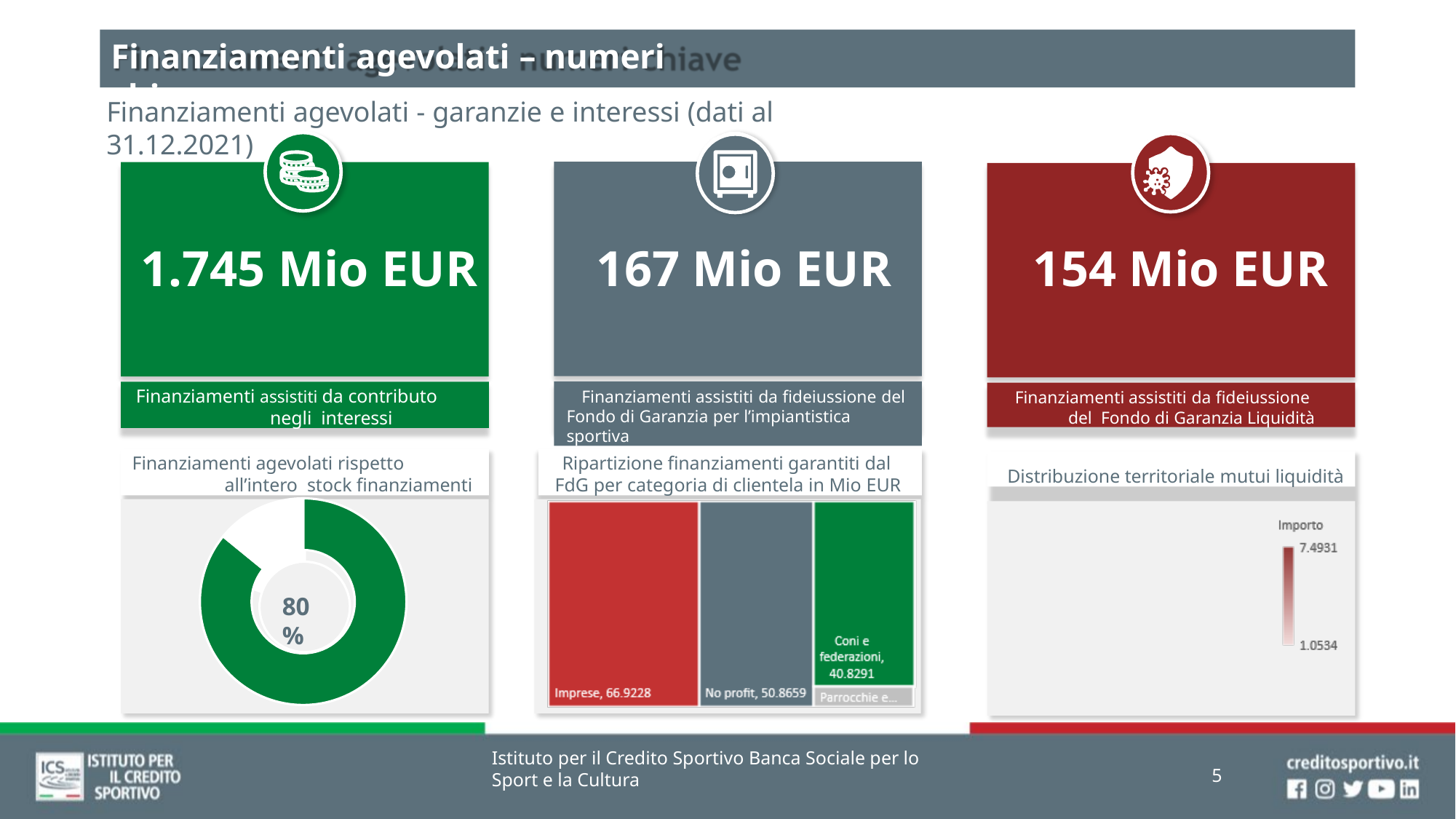
In the chart titled 'Ripartizione finanziamenti garantiti dal FdG per categoria di clientela in Mio EUR', what is the value for Coni e federazioni? 40.8291 In the chart titled 'Finanziamenti agevolati rispetto all'intero stock finanziamenti', what kind of chart is used? Donut chart In the chart titled 'Ripartizione finanziamenti garantiti dal FdG per categoria di clientela in Mio EUR', which is larger: No profit or Coni e federazioni? No profit In the chart titled 'Distribuzione territoriale mutui liquidità', what is the maximum value shown on the 'Importo' legend scale? 7.4931 In the chart titled 'Ripartizione finanziamenti garantiti dal FdG per categoria di clientela in Mio EUR', what kind of chart is used? Treemap In the chart titled 'Ripartizione finanziamenti garantiti dal FdG per categoria di clientela in Mio EUR', what is the difference between the values for No profit and Coni e federazioni? 10.0368 In the chart titled 'Ripartizione finanziamenti garantiti dal FdG per categoria di clientela in Mio EUR', what is the value for Imprese? 66.9228 In the chart titled 'Ripartizione finanziamenti garantiti dal FdG per categoria di clientela in Mio EUR', what is the value for No profit? 50.8659 In the chart titled 'Ripartizione finanziamenti garantiti dal FdG per categoria di clientela in Mio EUR', which category has the highest value? Imprese In the chart titled 'Distribuzione territoriale mutui liquidità', what is the minimum value shown on the 'Importo' legend scale? 1.0534 In the chart titled 'Finanziamenti agevolati rispetto all'intero stock finanziamenti', what percentage is shown in the centre of the donut? 80% In the chart titled 'Ripartizione finanziamenti garantiti dal FdG per categoria di clientela in Mio EUR', what is the difference between the values for Imprese and No profit? 16.0569